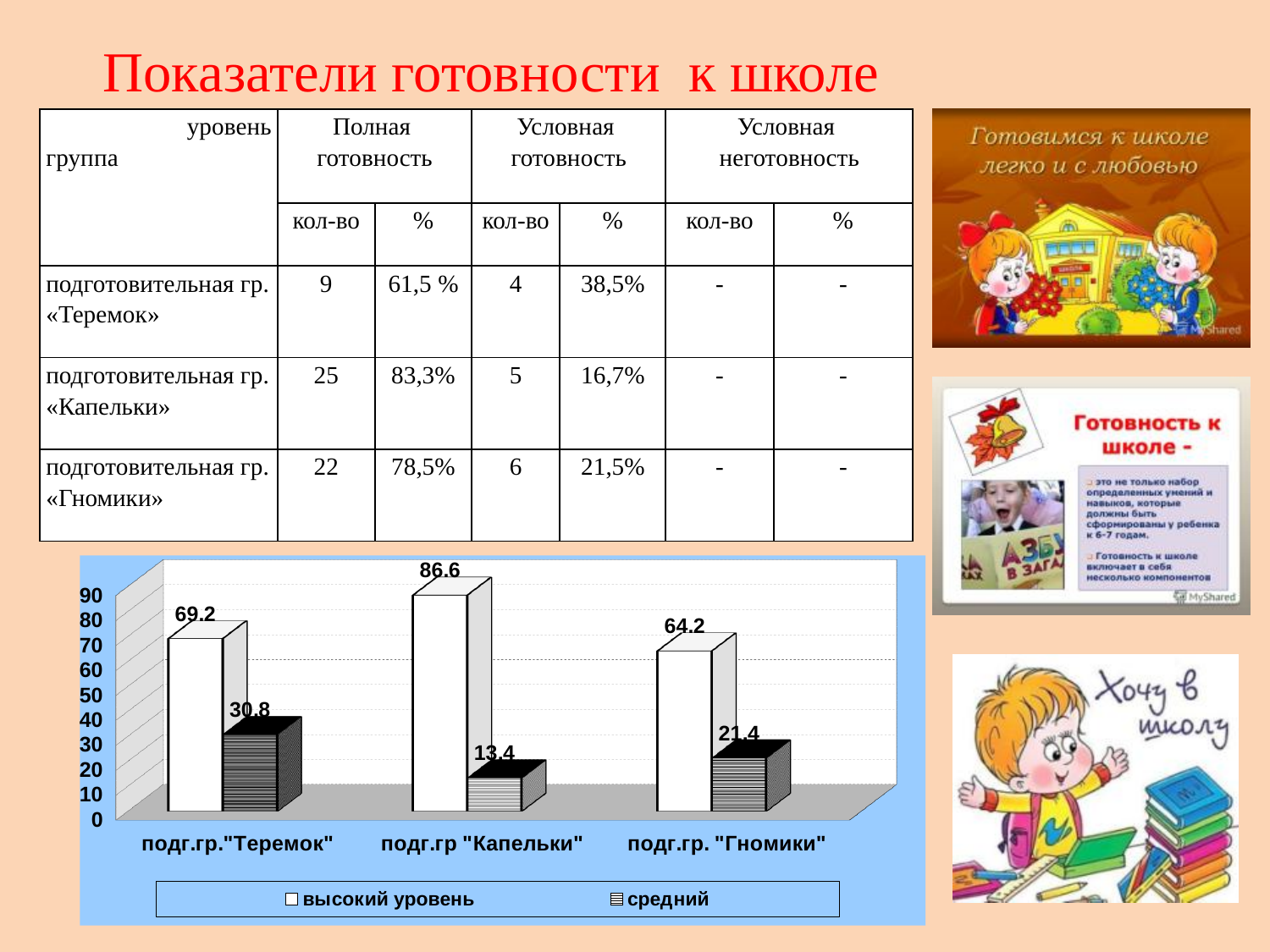
What is the value of "высокий уровень" for подг.гр "Капельки"? 86.6 What is the value of "средний" for подг.гр "Капельки"? 13.4 How many groups (categories) are shown on the x axis of the chart? 3 Which group has the lowest value for "средний"? подг.гр "Капельки" What type of chart is shown on the slide? bar chart Which group has the highest value for "высокий уровень"? подг.гр "Капельки" What is the value of "средний" for подг.гр."Теремок"? 30.8 What is the difference between the "высокий уровень" values for подг.гр "Капельки" and подг.гр."Теремок"? 17.4 What is the value of "высокий уровень" for подг.гр. "Гномики"? 64.2 What are the two series named in the chart legend? высокий уровень, средний How many series does the chart legend list? 2 Which is larger: the "средний" value for подг.гр."Теремок" or for подг.гр. "Гномики"? подг.гр."Теремок"